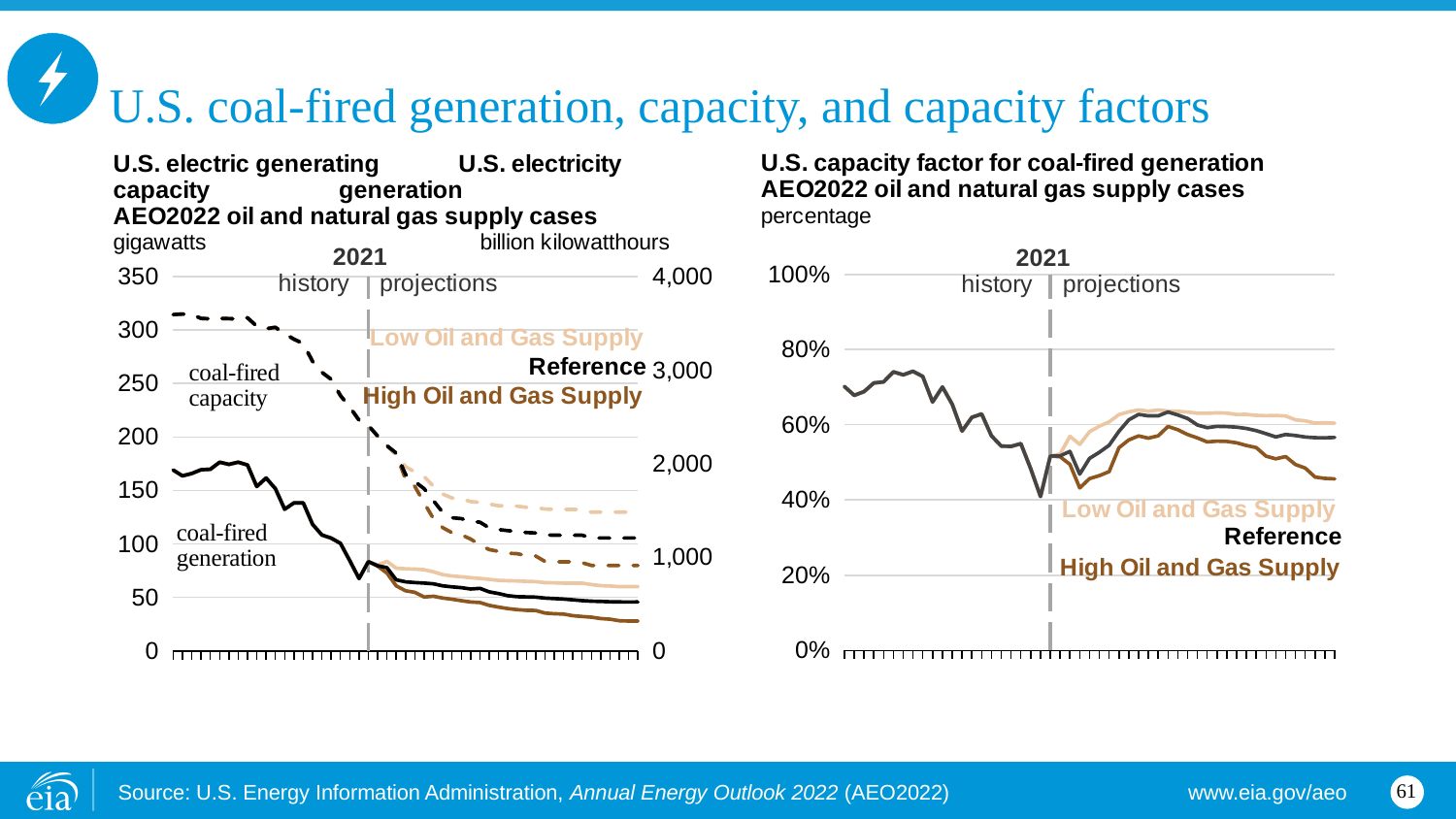
In the left chart, does coal-fired capacity rise or fall over the history period up to 2021? fall In the left chart, is the coal-fired capacity at the start of the history period greater or less than 300 gigawatts? greater What year does the dashed vertical line separating history from projections mark in both charts? 2021 In the U.S. capacity factor for coal-fired generation chart, is the capacity factor for the High Oil and Gas Supply case at the end of the projections greater or less than 60%? less What kind of chart is the U.S. capacity factor for coal-fired generation chart? line chart In the left chart, which case has the lowest coal-fired generation at the end of the projection period? High Oil and Gas Supply In the U.S. capacity factor for coal-fired generation chart, is the capacity factor at the start of the history period greater or less than 60%? greater In the U.S. capacity factor for coal-fired generation chart, which case has the lowest capacity factor at the end of the projection period? High Oil and Gas Supply In the U.S. capacity factor for coal-fired generation chart, which case has the highest capacity factor at the end of the projection period? Low Oil and Gas Supply In the U.S. capacity factor for coal-fired generation chart, does the capacity factor generally rise or fall over the history period up to 2021? fall In the U.S. capacity factor for coal-fired generation chart, how many AEO2022 cases are labelled? 3